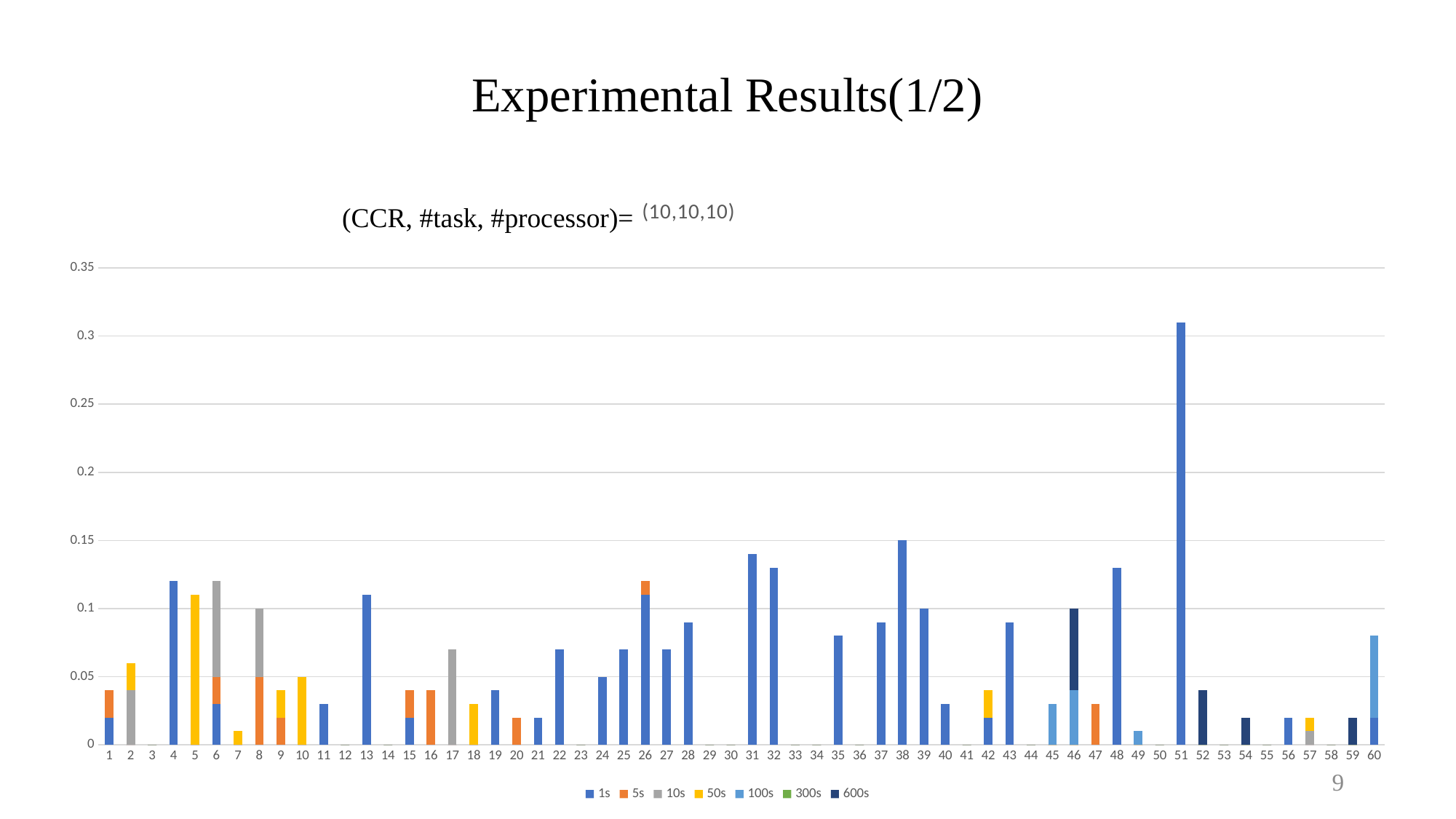
What value does the bar for category 39 reach? 0.1 How many series does the legend list? 7 Which category has the tallest bar? 51 How many categories are shown along the x axis? 60 Is the value for category 51 greater or less than 0.25? greater What kind of chart is shown on the slide? bar chart Which series does the tallest bar (category 51) belong to? 1s Which bar is taller, category 38 or category 32? 38 Is the value for category 22 greater or less than 0.05? greater What value does the bar for category 38 reach? 0.15 What is the chart's title? (10,10,10) Is the value for category 31 greater or less than 0.1? greater